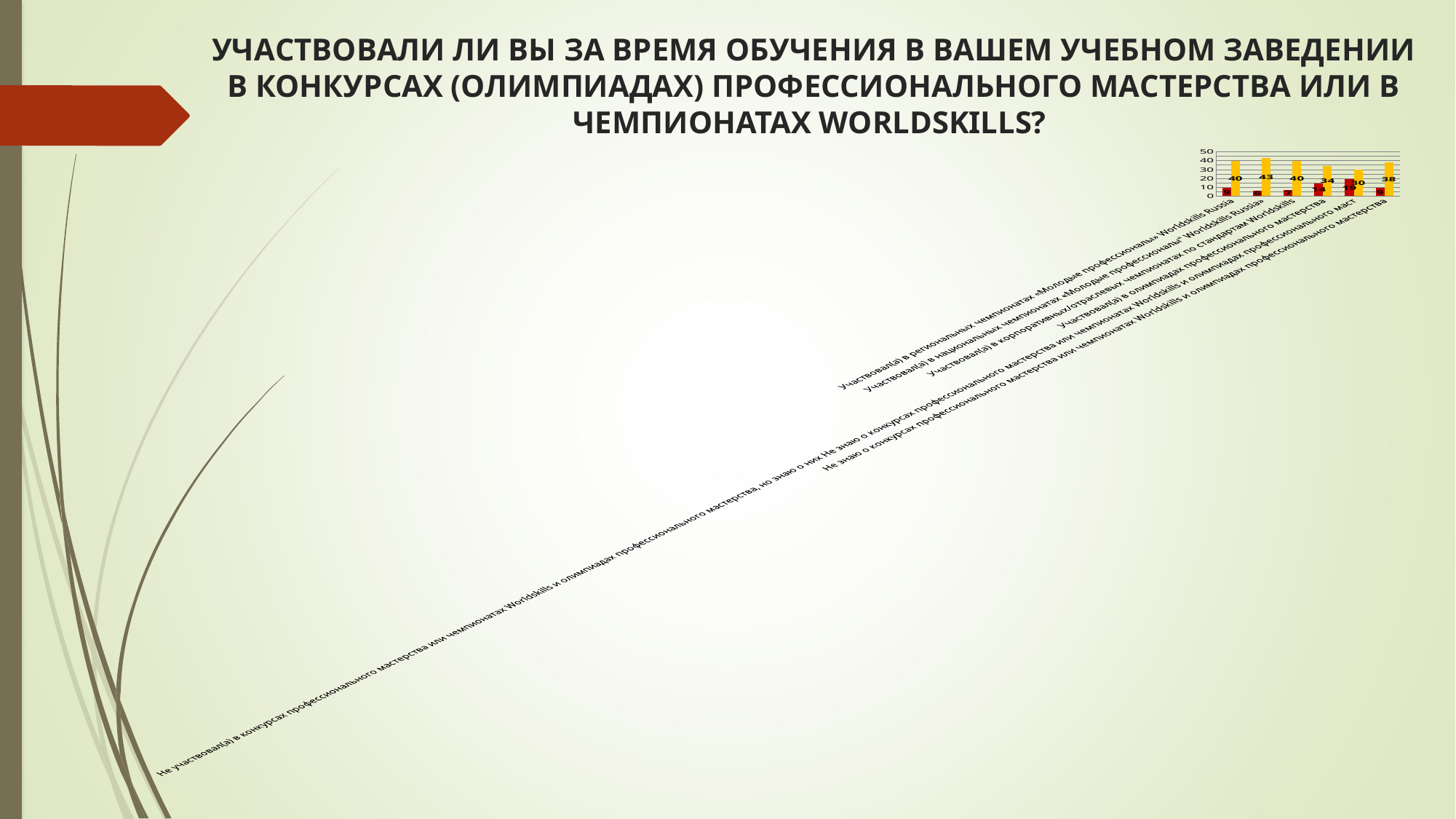
What is the value of the second yellow bar in the chart? 43 How many categories (groups of bars) does the chart show? 6 What is the highest value shown on the chart's vertical axis? 50 Which yellow bar has the highest value, and what is it? the second bar, 43 Which yellow bar has the lowest value, and what is it? the fifth bar, 30 What kind of chart is shown on the slide? bar chart What is the value of the fourth yellow bar in the chart? 34 What is the value of the last (sixth) yellow bar in the chart? 38 Is the value of the third yellow bar greater or less than 30? greater Which is larger: the fourth yellow bar or the sixth yellow bar? the sixth yellow bar (38) What is the difference between the highest yellow bar (43) and the lowest yellow bar (30)? 13 What is the value of the first yellow bar in the chart? 40